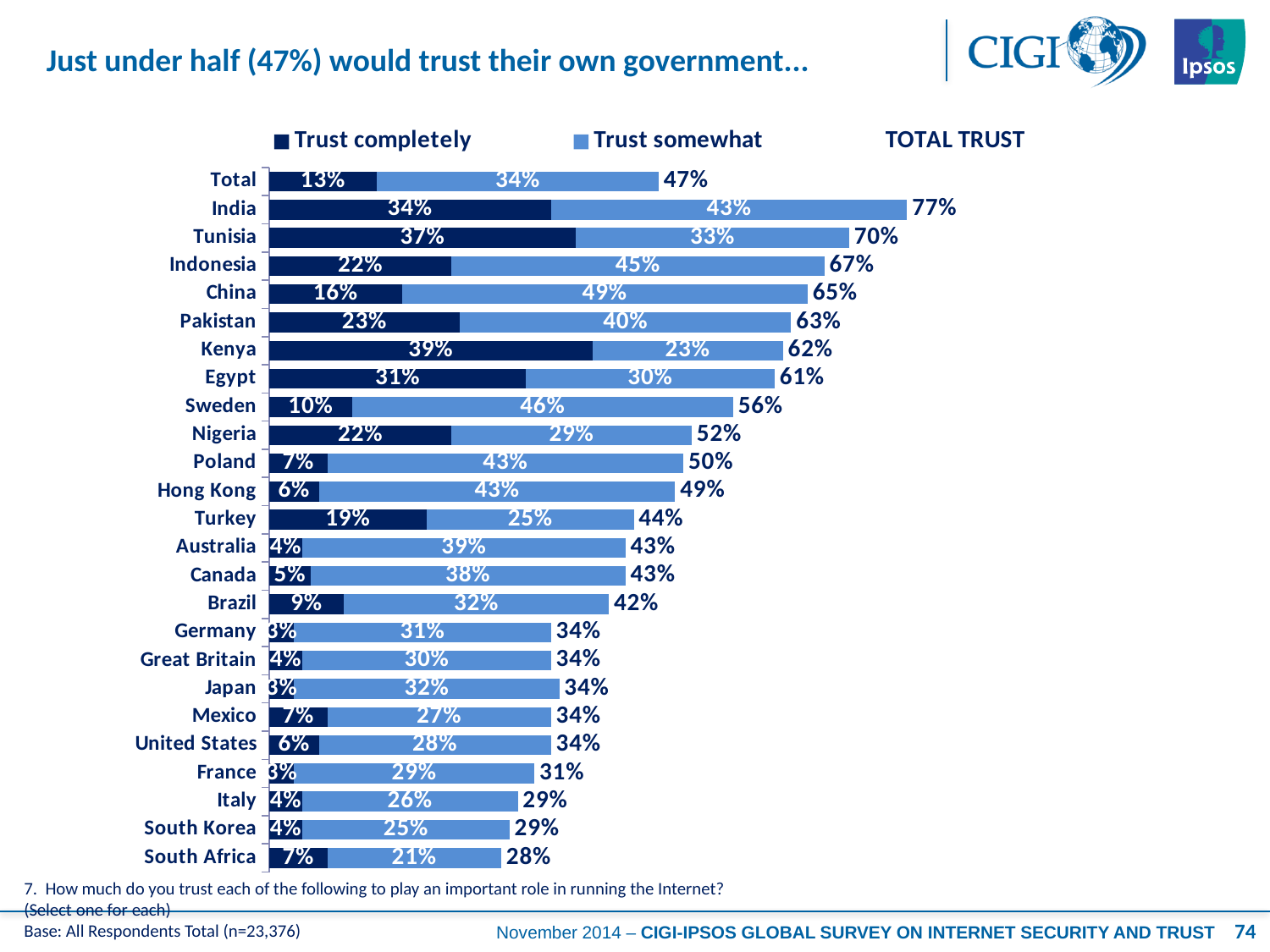
How many series does the legend list? 2 What is the difference between the 'Trust somewhat' value for Indonesia and the 'Trust completely' value for Indonesia? 23% Which country has the highest total trust? India Which is larger, the 'Trust completely' value for Tunisia or for Egypt? Tunisia Which country has the lowest total trust? South Africa What is the 'Trust completely' value for Kenya? 39% What is the 'Trust somewhat' value for China? 49% What is the total trust value for the 'Total' row? 47% What is the total trust value for Sweden? 56% What is the difference between the total trust for India and the total trust for Tunisia? 7% How many categories (rows) are plotted in the chart? 25 What kind of chart is shown on the slide? Stacked bar chart